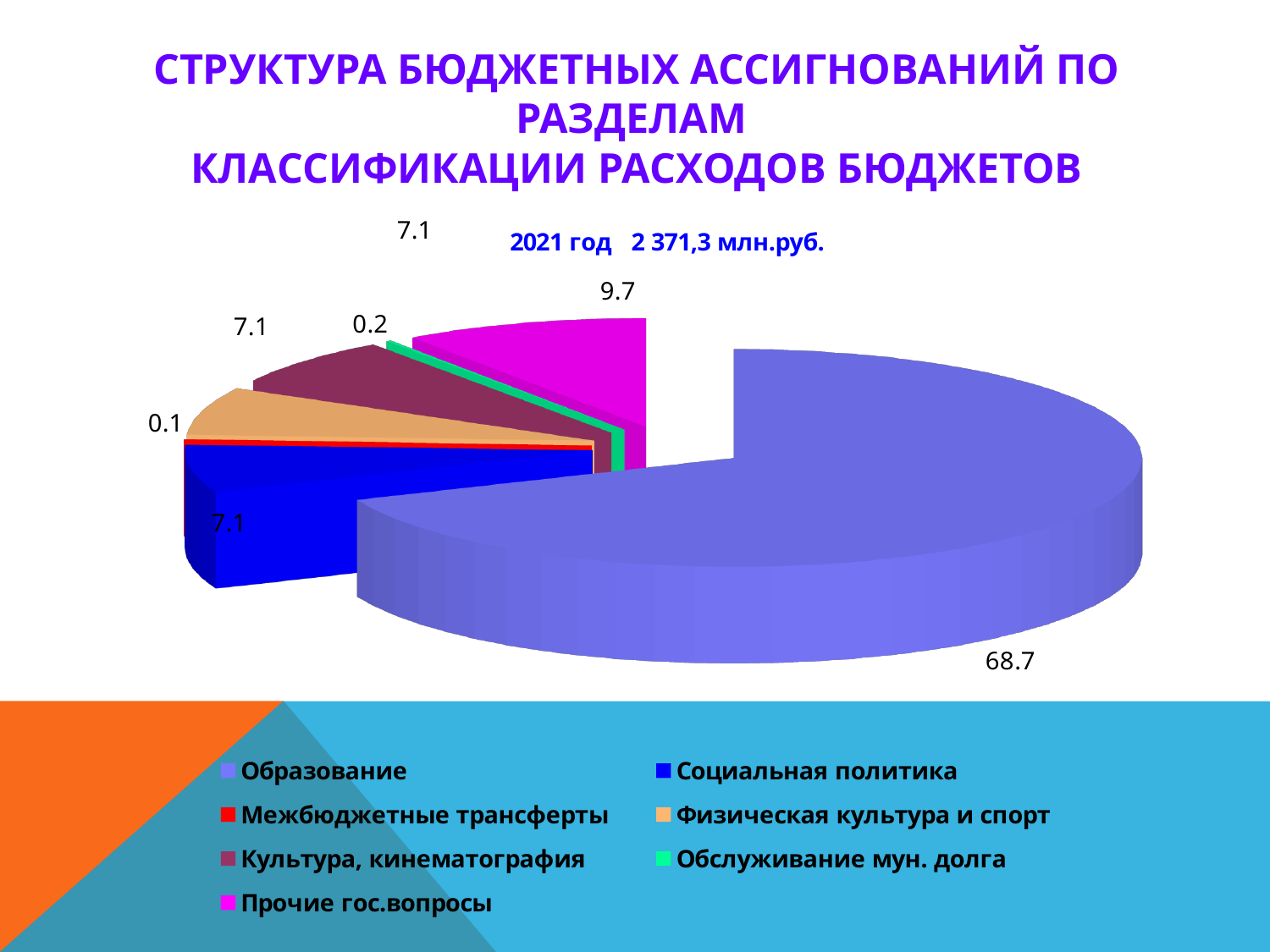
What value is shown for the Обслуживание мун. долга slice? 0.2 What value is shown for the Прочие гос.вопросы slice? 9.7 How many categories does the legend list? 7 What value is shown for the Социальная политика slice? 7.1 What total budget amount for 2021 is stated above the chart? 2 371,3 млн.руб. Which is larger, the value for Прочие гос.вопросы or the value for Социальная политика? Прочие гос.вопросы What value is shown for the Образование slice? 68.7 Which category has the smallest slice of the pie? Межбюджетные трансферты What kind of chart is shown on the slide? Pie chart Which category has the largest slice of the pie? Образование What is the difference between the values for Образование and Прочие гос.вопросы? 59 What value is shown for the Межбюджетные трансферты slice? 0.1